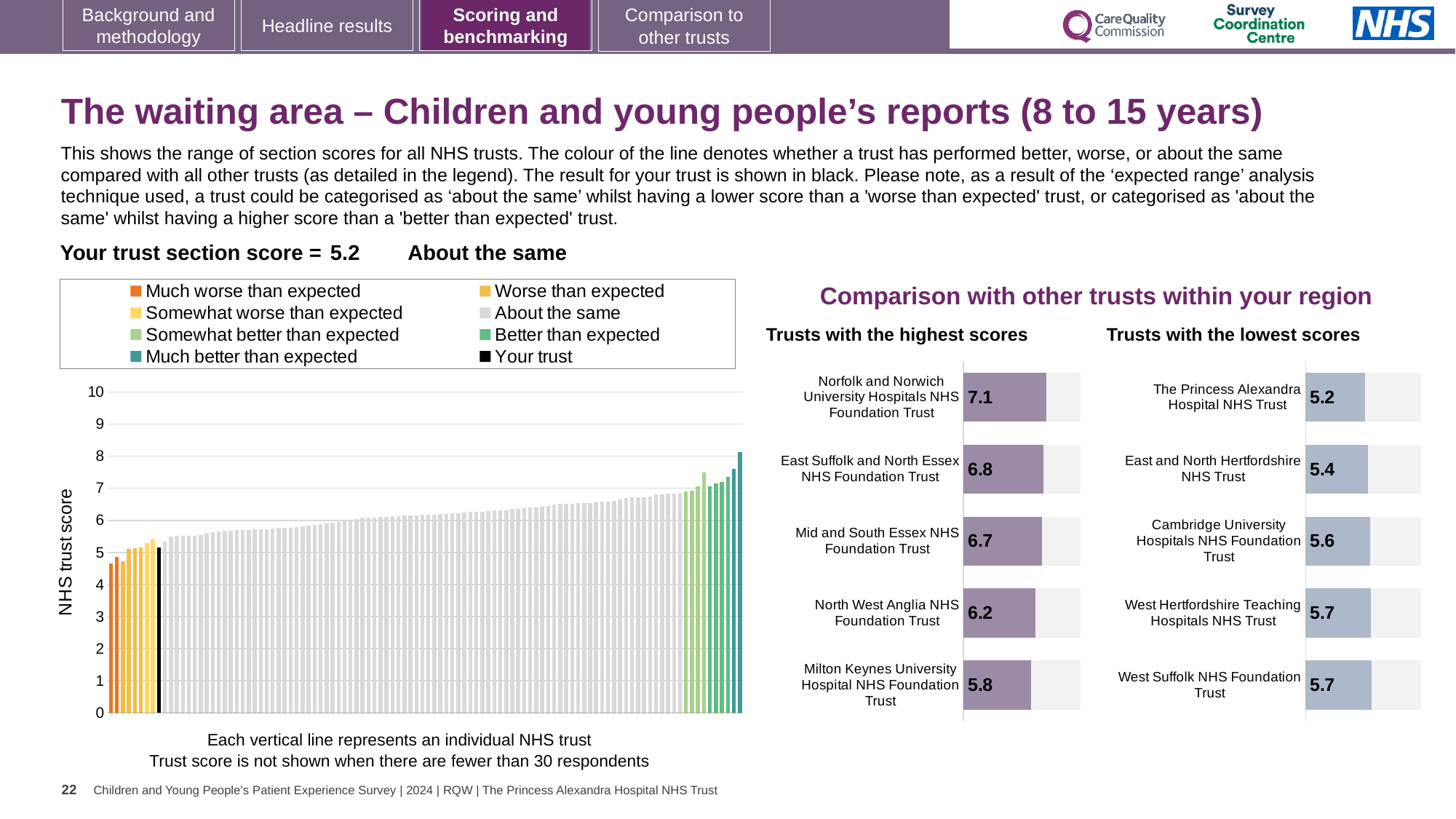
In the 'Trusts with the highest scores' chart, what is the score for Milton Keynes University Hospital NHS Foundation Trust? 5.8 In the 'Trusts with the lowest scores' chart, which has the larger score: East and North Hertfordshire NHS Trust or Cambridge University Hospitals NHS Foundation Trust? Cambridge University Hospitals NHS Foundation Trust In the 'Trusts with the highest scores' chart, what is the difference between the scores of Norfolk and Norwich University Hospitals NHS Foundation Trust and Milton Keynes University Hospital NHS Foundation Trust? 1.3 In the main chart on the left showing all NHS trusts, do the bar values rise or fall from left to right? rise In the 'Trusts with the highest scores' chart, which trust has the highest score? Norfolk and Norwich University Hospitals NHS Foundation Trust In the 'Trusts with the lowest scores' chart, what is the score for Cambridge University Hospitals NHS Foundation Trust? 5.6 How many entries does the legend of the main chart on the left list? 8 In the 'Trusts with the lowest scores' chart, what is the difference between the scores of Cambridge University Hospitals NHS Foundation Trust and The Princess Alexandra Hospital NHS Trust? 0.4 In the main chart on the left showing all NHS trusts, is the value for the lowest-scoring trust greater or less than 5? less In the 'Trusts with the highest scores' chart, what is the score for Norfolk and Norwich University Hospitals NHS Foundation Trust? 7.1 How many trusts are listed in the 'Trusts with the highest scores' chart? 5 In the 'Trusts with the lowest scores' chart, which trust has the lowest score? The Princess Alexandra Hospital NHS Trust